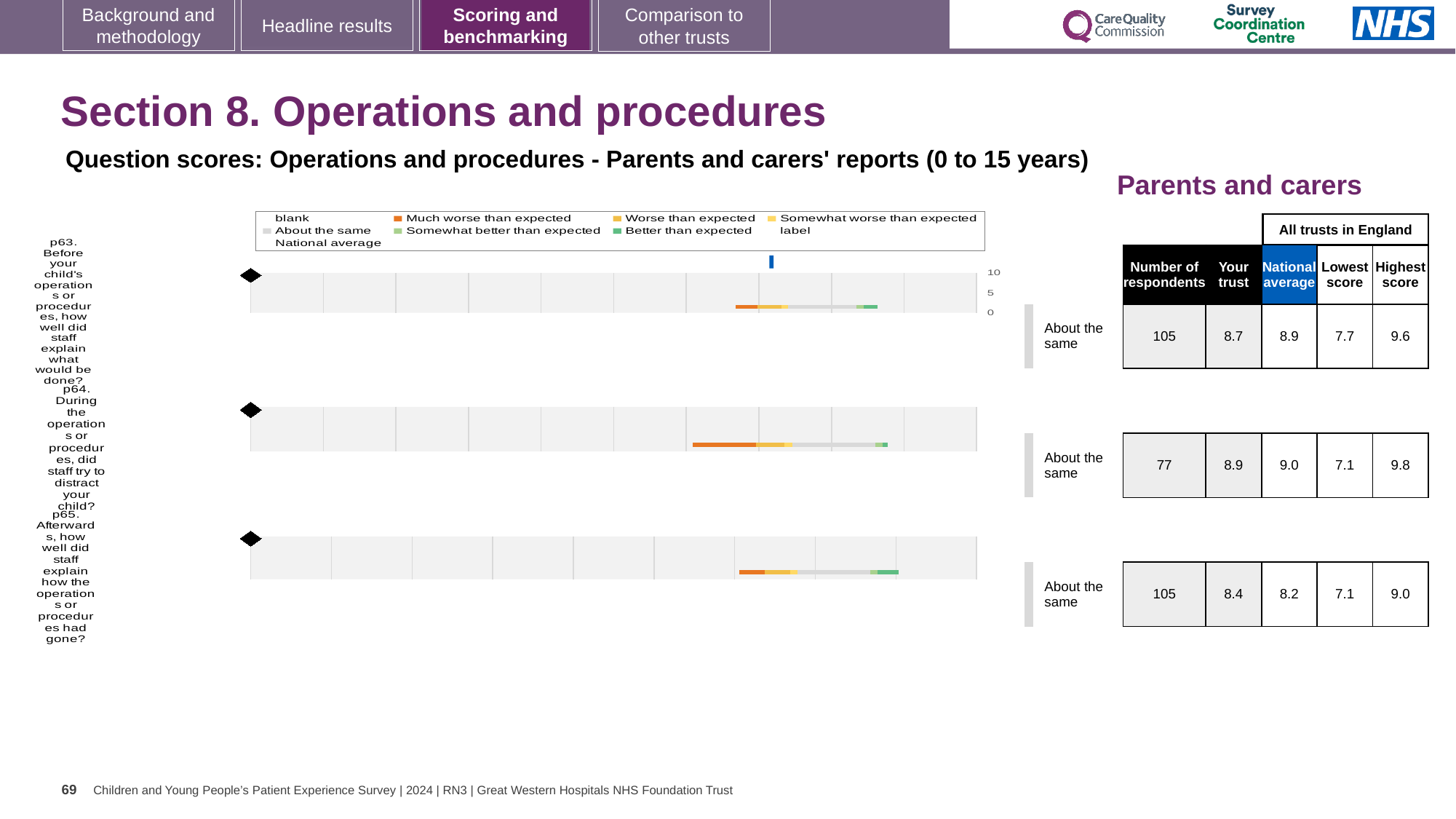
For p65, what is the difference between the 'Your trust' score and the National average? 0.2 What is the National average score for p64 (During the operations or procedures, did staff try to distract your child?)? 9.0 Which question has the highest 'Your trust' score? p64 What kind of chart is used to show the question scores for p63, p64 and p65? bar chart How many questions (p63, p64, p65) are plotted on the slide? 3 Which question has the lowest 'Your trust' score? p65 For p64, what is the difference between the Highest score and the Lowest score among all trusts in England? 2.7 For p63, which is larger: the 'Your trust' score or the National average? National average How many respondents answered p64? 77 What is the Highest score among all trusts in England for p65 (Afterwards, how well did staff explain how the operations or procedures had gone?)? 9.0 What is the 'Your trust' score for p63 (Before your child's operations or procedures, how well did staff explain what would be done?)? 8.7 What benchmark category is shown next to each of the three question charts? About the same